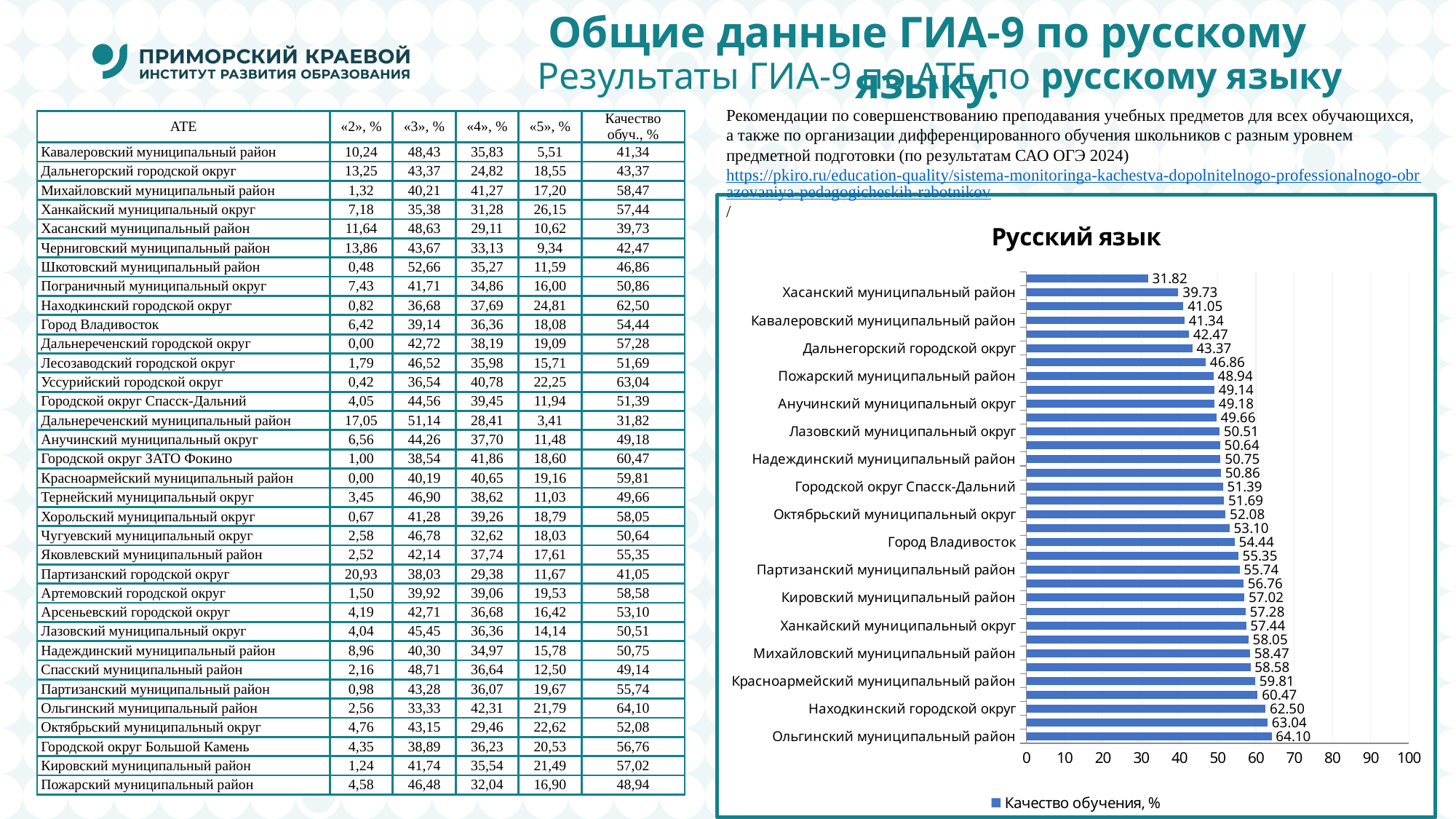
In the "Русский язык" chart, what is the smallest value shown on any bar? 31.82 In the "Русский язык" chart, is the value for Дальнегорский городской округ greater or less than 50? less In the "Русский язык" chart, what is the value for Находкинский городской округ? 62.50 What type of chart is shown under the title "Русский язык"? bar chart In the "Русский язык" chart, what is the value for Хасанский муниципальный район? 39.73 In the "Русский язык" chart, what is the difference between the values for Ольгинский муниципальный район and Хасанский муниципальный район? 24.37 In the "Русский язык" chart, which is larger: the value for Кировский муниципальный район or the value for Ханкайский муниципальный округ? Ханкайский муниципальный округ In the "Русский язык" chart, what is the value for Ольгинский муниципальный район? 64.10 In the "Русский язык" chart, what is the value for Город Владивосток? 54.44 In the "Русский язык" chart, which labelled category has the highest value? Ольгинский муниципальный район How many series does the legend of the "Русский язык" chart list? 1 What is the legend entry of the "Русский язык" chart? Качество обучения, %